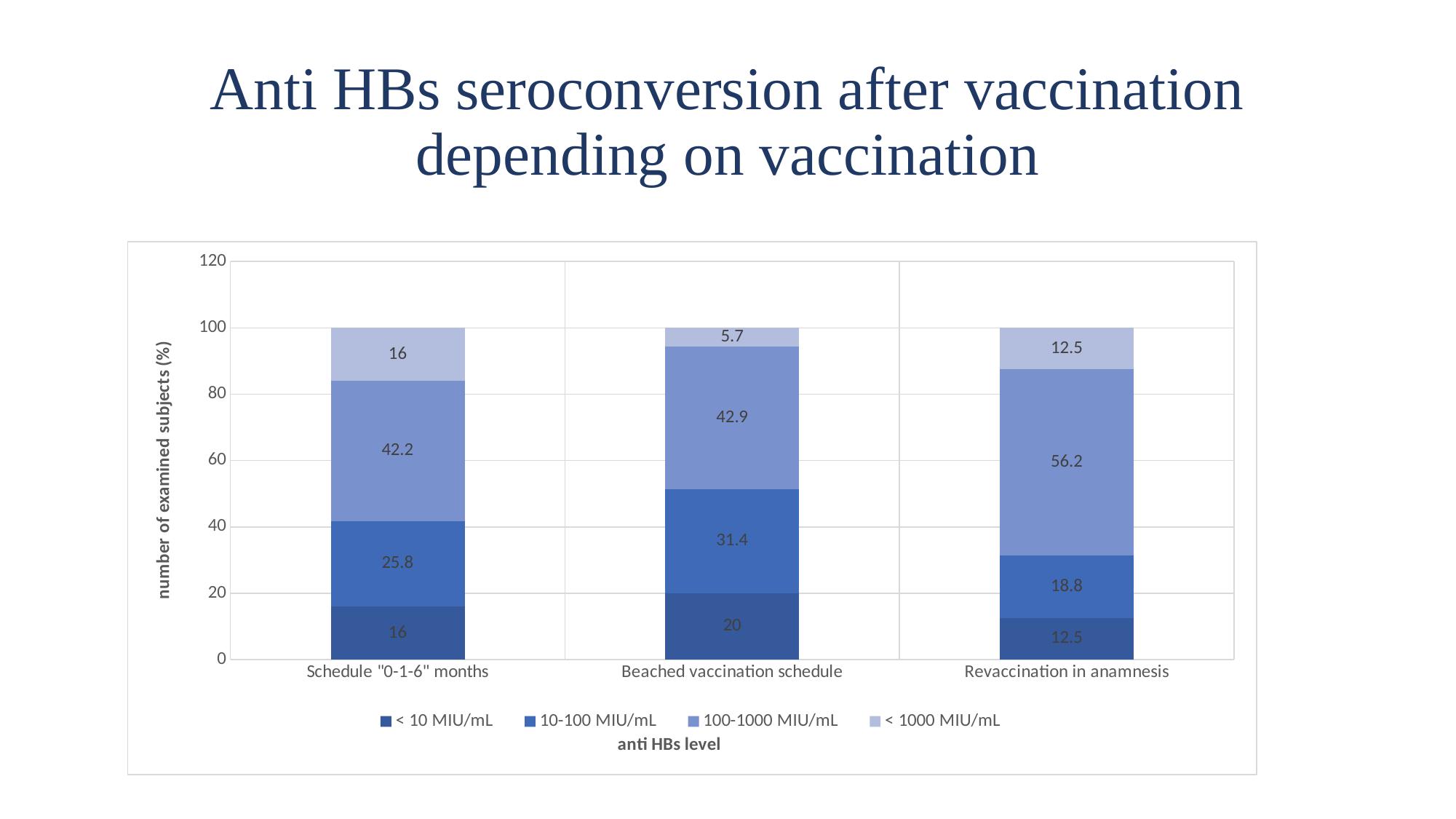
What is the difference between the 100-1000 MIU/mL values for "Revaccination in anamnesis" and "Beached vaccination schedule"? 13.3 What is the label of the y axis? number of examined subjects (%) What is the total of the stacked bar for "Beached vaccination schedule"? 100 What is the value of the 10-100 MIU/mL segment for "Beached vaccination schedule"? 31.4 How many categories are shown on the x axis? 3 Which category has the lowest value for the < 1000 MIU/mL series (the top segment)? Beached vaccination schedule Which is larger: the 10-100 MIU/mL value for "Schedule "0-1-6" months" or for "Revaccination in anamnesis"? Schedule "0-1-6" months Which category has the highest value for the 100-1000 MIU/mL series? Revaccination in anamnesis What is the value of the < 10 MIU/mL segment for "Schedule "0-1-6" months"? 16 What kind of chart is shown on the slide? Stacked bar chart How many series does the legend list? 4 What is the value of the 100-1000 MIU/mL segment for "Revaccination in anamnesis"? 56.2